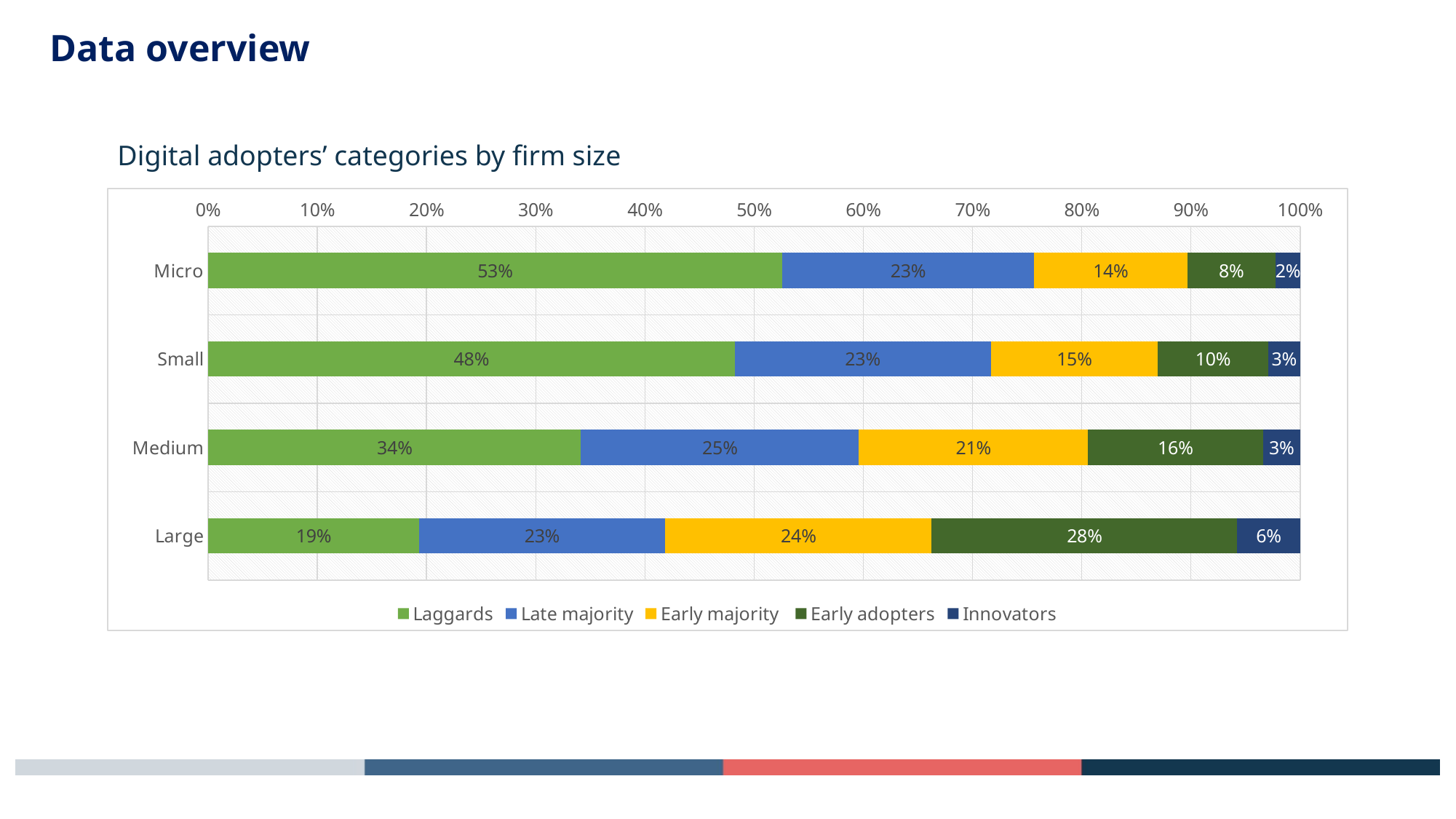
How many firm size categories are shown on the chart? 4 What is the difference between the Laggards share for Micro firms and for Large firms? 34% What percentage of Large firms are Early adopters? 28% What is the title of the chart? Digital adopters' categories by firm size What percentage of Small firms are Innovators? 3% How many series does the legend list? 5 Which is larger: the Early adopters share for Medium firms or for Small firms? Medium Which firm size has the highest share of Laggards? Micro What kind of chart is shown on the slide? Stacked bar chart What percentage of Micro firms are Laggards? 53% Which firm size has the lowest share of Innovators? Micro What percentage of Medium firms are Early majority? 21%